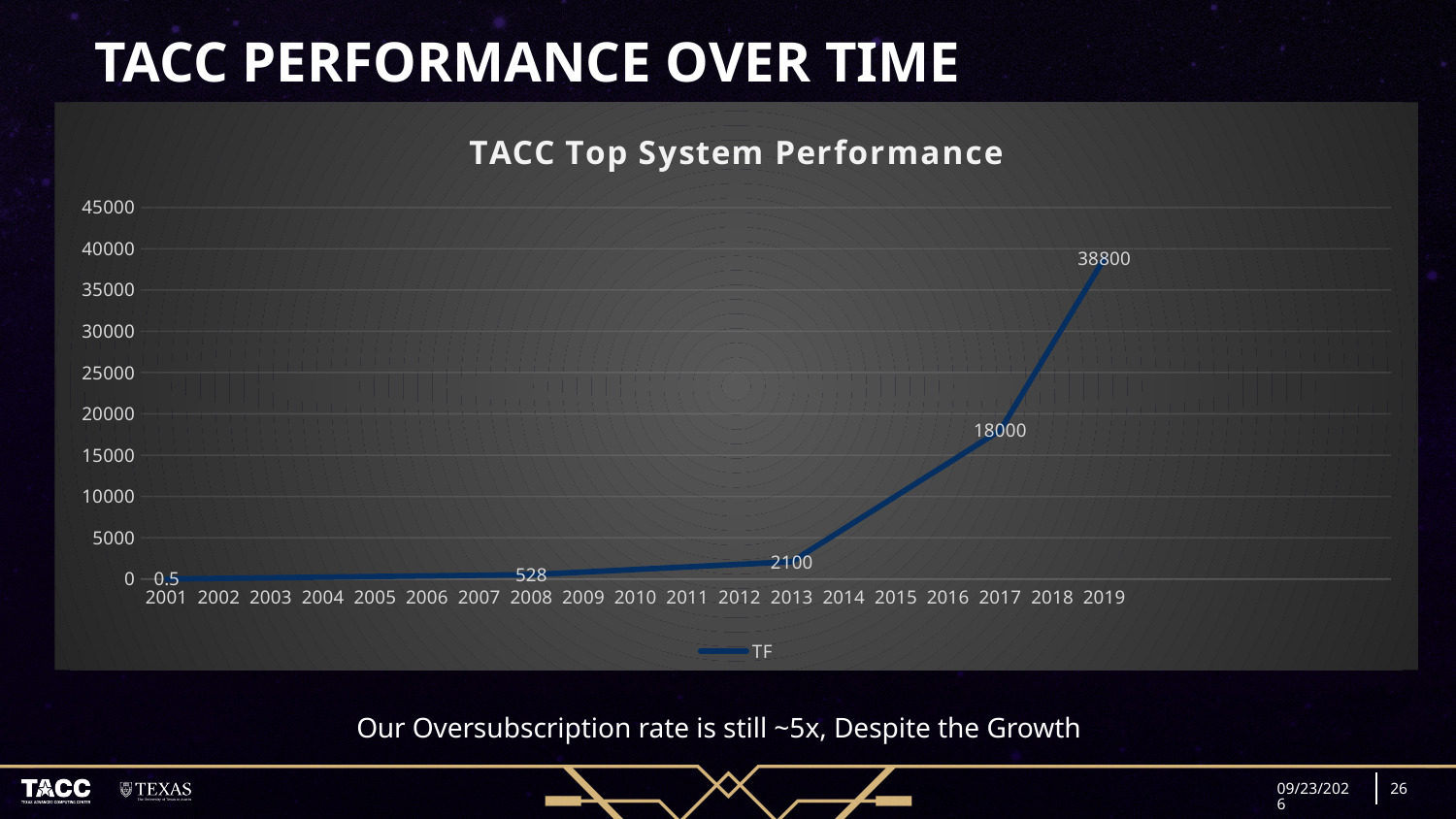
What is the TF value labeled for 2013? 2100 What is the difference between the TF values for 2019 and 2017? 20800 What is the TF value labeled for 2008? 528 How many series does the legend list? 1 Which year has the highest labeled TF value? 2019 What series name does the legend show? TF What type of chart is shown on the slide? line chart What is the TF value labeled for 2017? 18000 What is the title of the chart? TACC Top System Performance What is the TF value labeled for 2001? 0.5 What is the TF value labeled for 2019? 38800 Does the TF value rise or fall from 2001 to 2019? rise